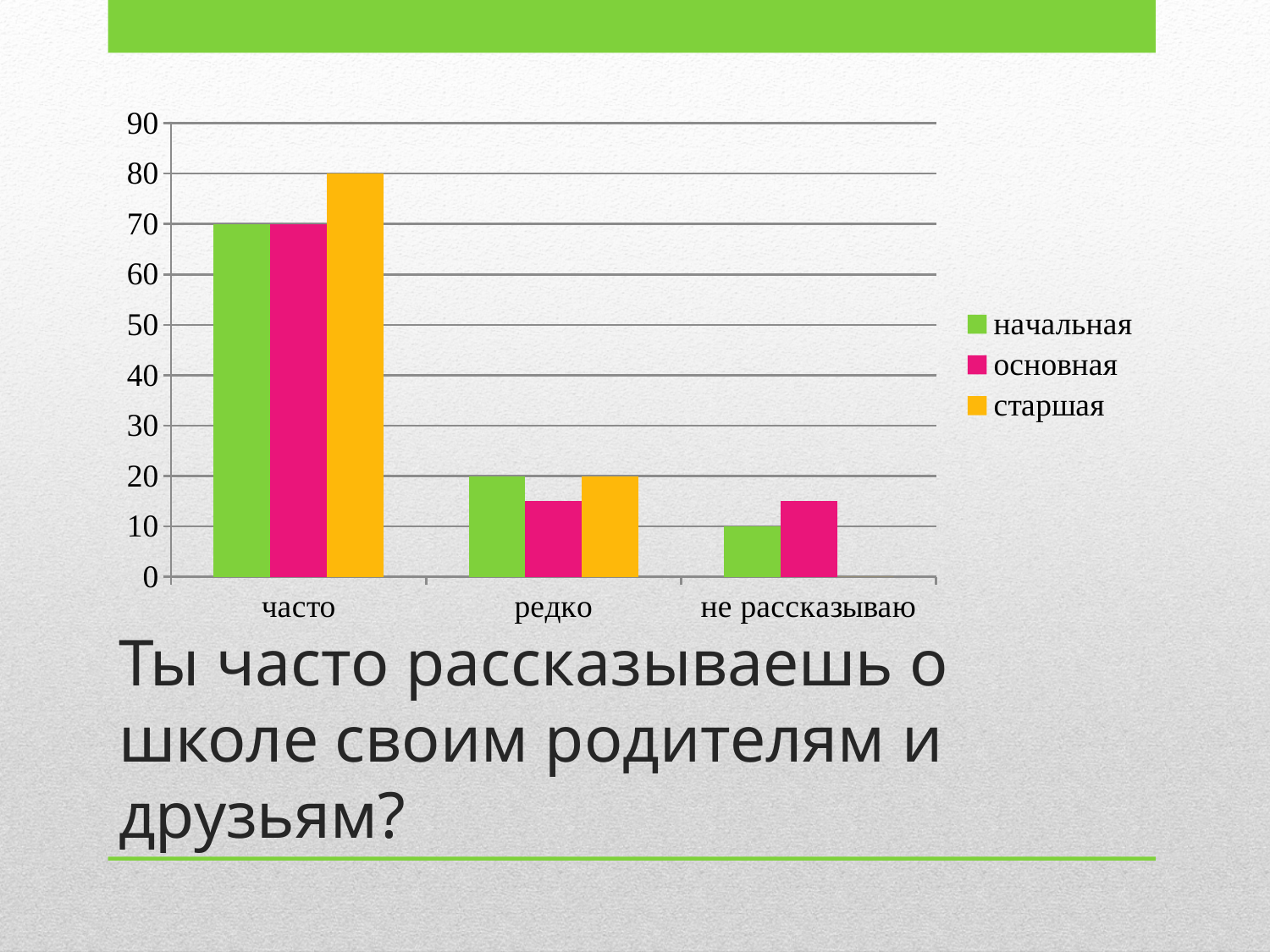
What is the value for начальная in the category не рассказываю? 10 What is the value for старшая in the category часто? 80 What is the value for начальная in the category редко? 20 Is the value for основная in the category редко greater or less than 20? less How many categories are shown on the x axis? 3 In the category часто, what is the difference between the values for старшая and начальная? 10 Which category has the highest value for the series старшая? часто How many series does the legend list? 3 In the category редко, which series has the larger value, начальная or основная? начальная What kind of chart is shown on the slide? bar chart Do the values for the series начальная rise or fall from часто to не рассказываю? fall What is the value for начальная in the category часто? 70